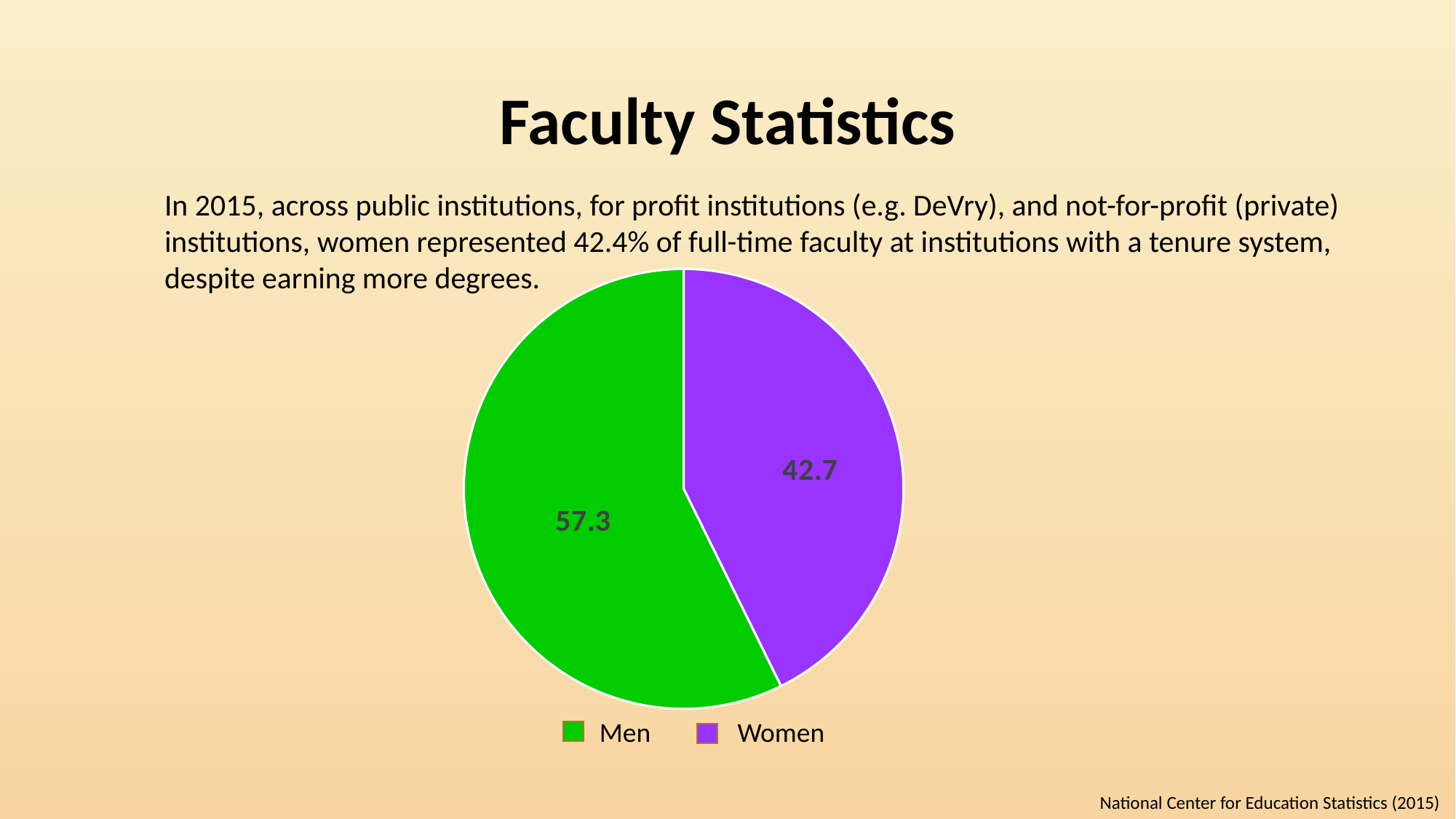
What is the difference between the values for Men and Women in the pie chart? 14.6 How many entries does the legend of the pie chart list? 2 Which slice of the pie chart is the smallest? Women How many slices does the pie chart have? 2 What colour is the Men slice in the pie chart? green What kind of chart is shown on the slide? pie chart What is the total of the two values shown in the pie chart? 100 What colour is the Women slice in the pie chart? purple Which is larger in the pie chart, the value for Men or the value for Women? Men What is the value shown for Women in the pie chart? 42.7 What is the value shown for Men in the pie chart? 57.3 Which slice of the pie chart is the largest? Men